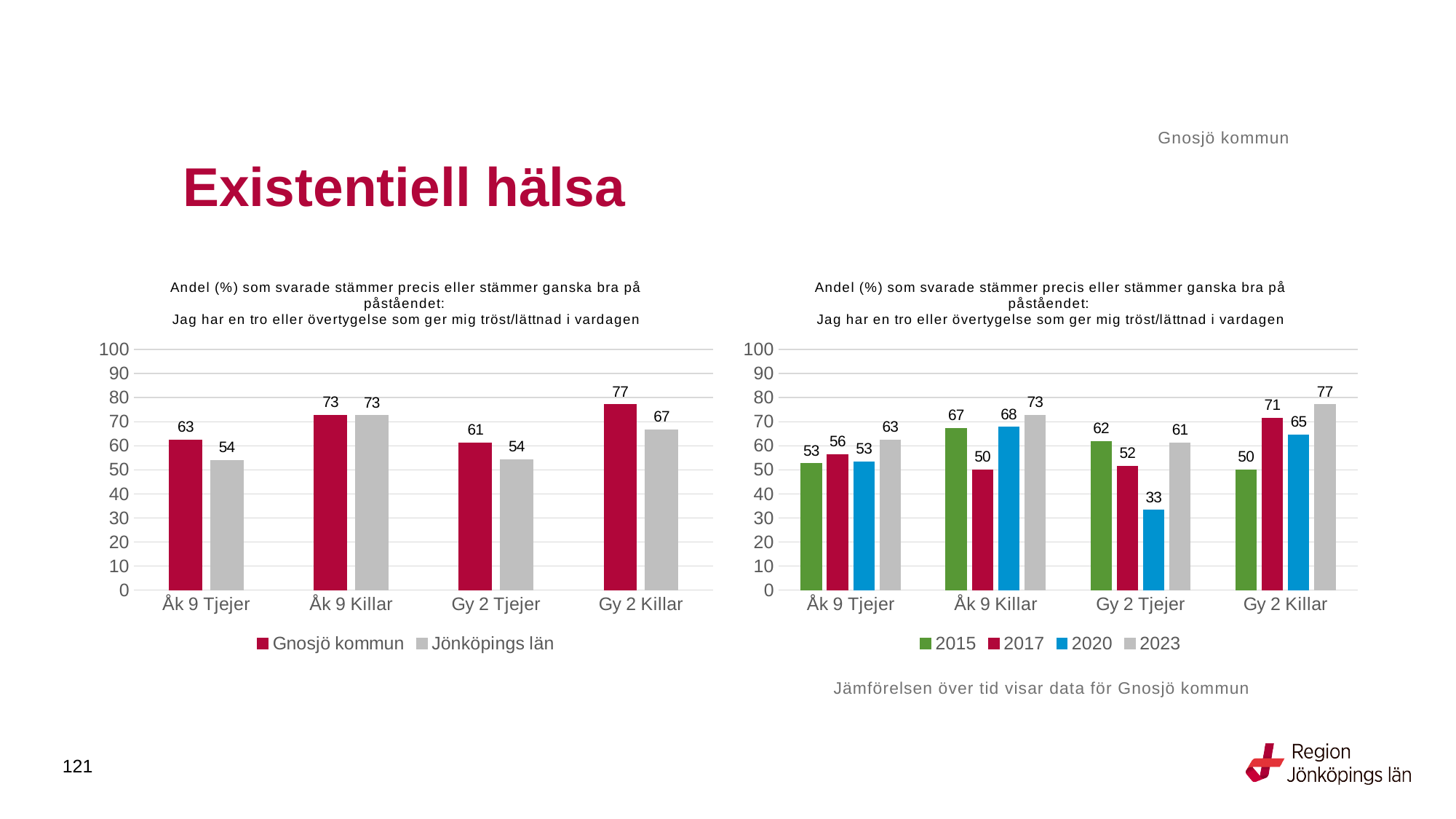
In the right chart, what is the value for 2017 for Gy 2 Killar? 71 In the right chart, how many categories are shown on the x axis? 4 In the left chart, how many series does the legend list? 2 In the left chart, what is the value for Gnosjö kommun for Åk 9 Tjejer? 63 In the left chart, which category has the highest value for Gnosjö kommun? Gy 2 Killar In the right chart, how many series does the legend list? 4 In the right chart, which category has the lowest value for 2020? Gy 2 Tjejer In the right chart, what is the value for 2020 for Gy 2 Tjejer? 33 In the left chart, what is the value for Jönköpings län for Gy 2 Killar? 67 What kind of chart is the right chart? Bar chart In the right chart, is the value for 2023 for Åk 9 Killar larger than the value for 2015 for Åk 9 Killar? Yes In the left chart, what is the difference between Gnosjö kommun and Jönköpings län for Gy 2 Tjejer? 7